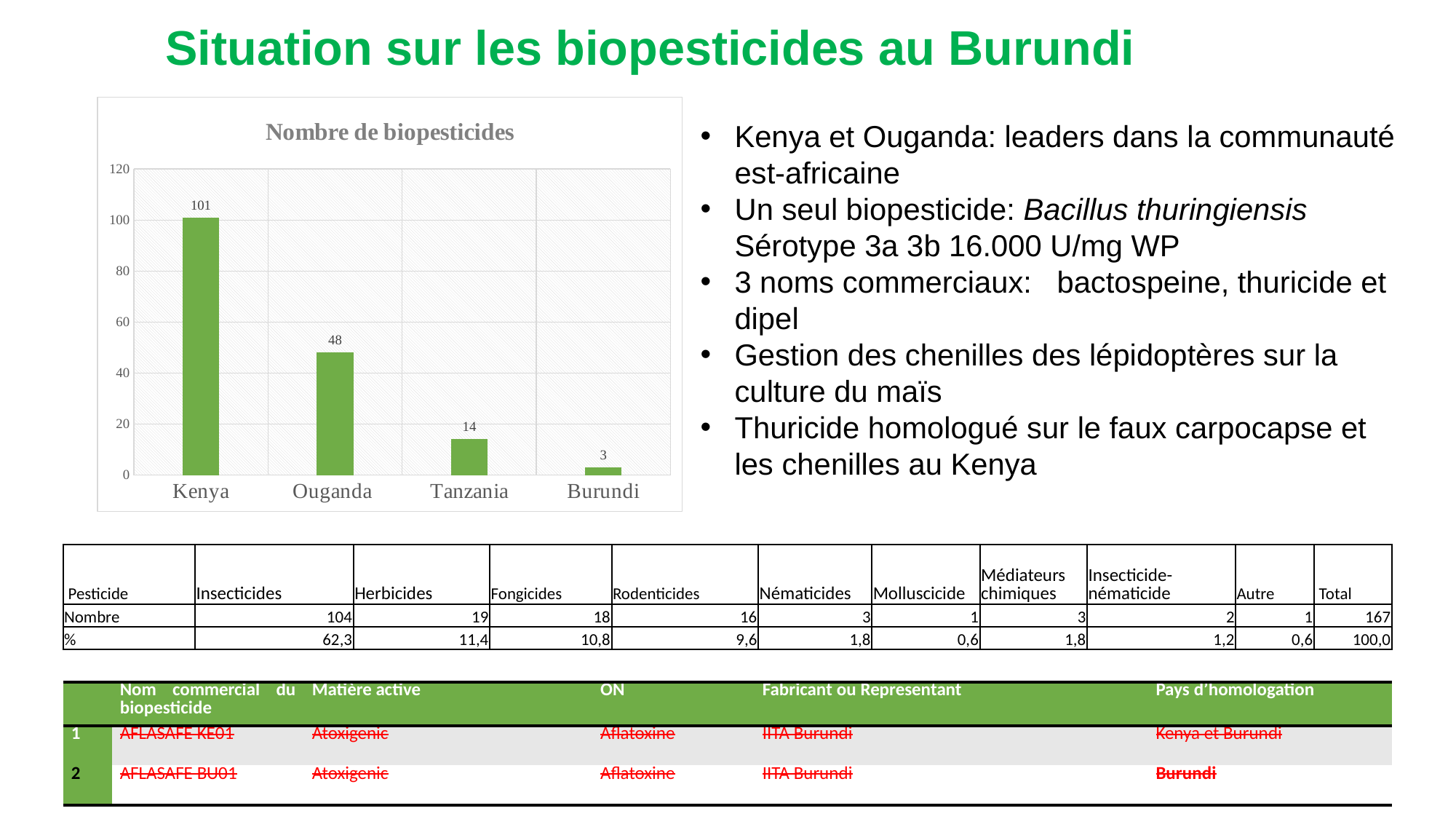
What type of chart is used to show the number of biopesticides? Bar chart What is the value for Ouganda in the 'Nombre de biopesticides' chart? 48 Which country has the highest number of biopesticides in the chart? Kenya What is the value for Burundi in the 'Nombre de biopesticides' chart? 3 Which has a larger value in the chart, Ouganda or Tanzania? Ouganda What is the difference between the values for Tanzania and Burundi in the chart? 11 What is the difference between the values for Kenya and Ouganda in the chart? 53 What is the value for Kenya in the 'Nombre de biopesticides' chart? 101 How many countries are shown in the 'Nombre de biopesticides' chart? 4 What is the value for Tanzania in the 'Nombre de biopesticides' chart? 14 Is the value for Ouganda in the chart greater or less than 60? less Which country has the lowest number of biopesticides in the chart? Burundi